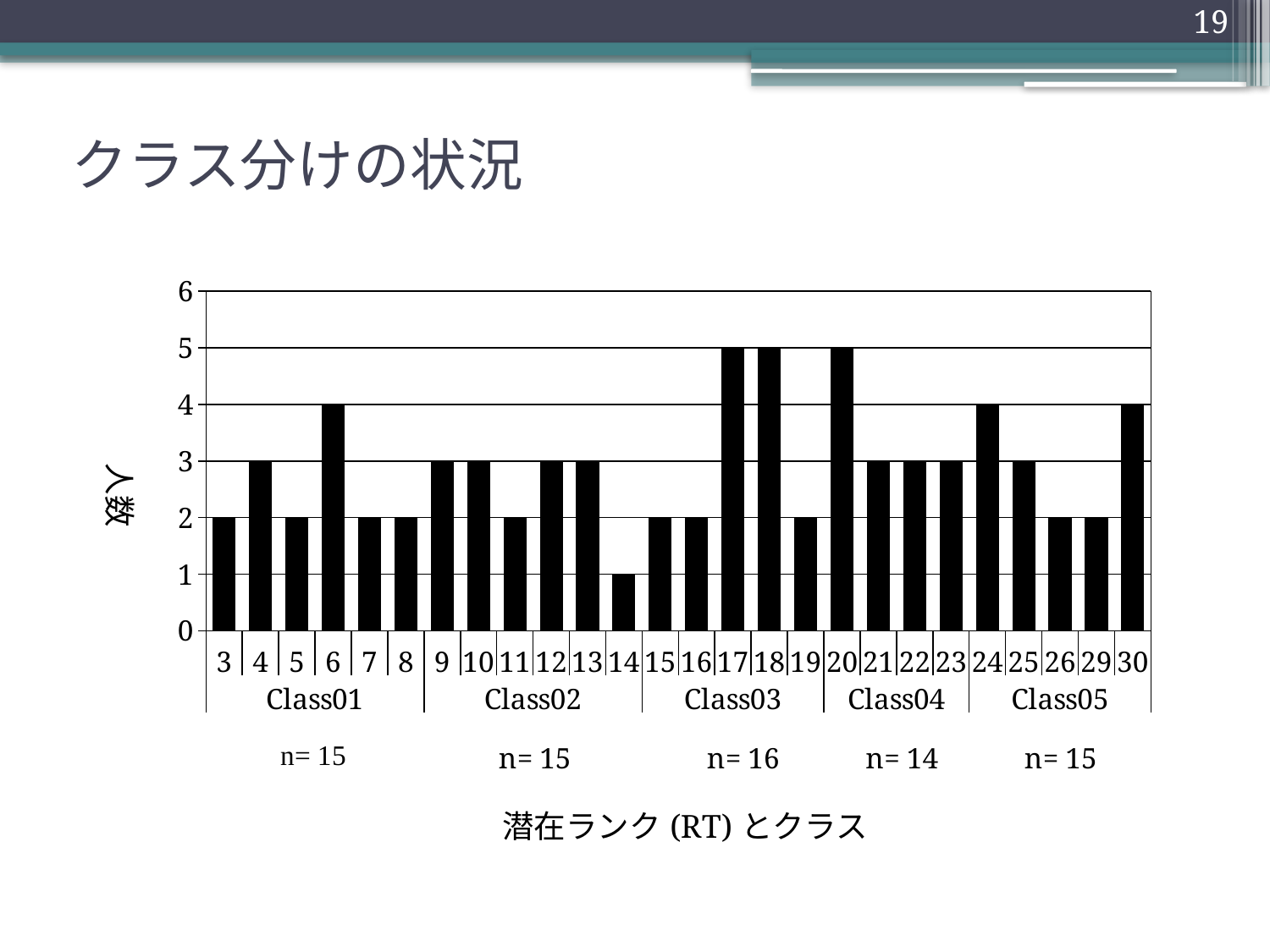
What is the difference between the value for rank 24 and the value for rank 26? 2 What is the highest value reached by any bar in the chart? 5 What is the value (人数) for rank 6 in Class01? 4 What type of chart is shown on the slide? bar chart What is the value for rank 20 in Class04? 5 What is the n value shown for Class04? n= 14 Which is larger, the value for rank 17 or the value for rank 19? rank 17 What is the x-axis label of the chart? 潜在ランク (RT) とクラス Which rank has the lowest value in the chart? 14 What is the value for rank 14 in Class02? 1 How many ranks are grouped under Class03? 5 How many ranks (bars) are plotted in the chart? 26